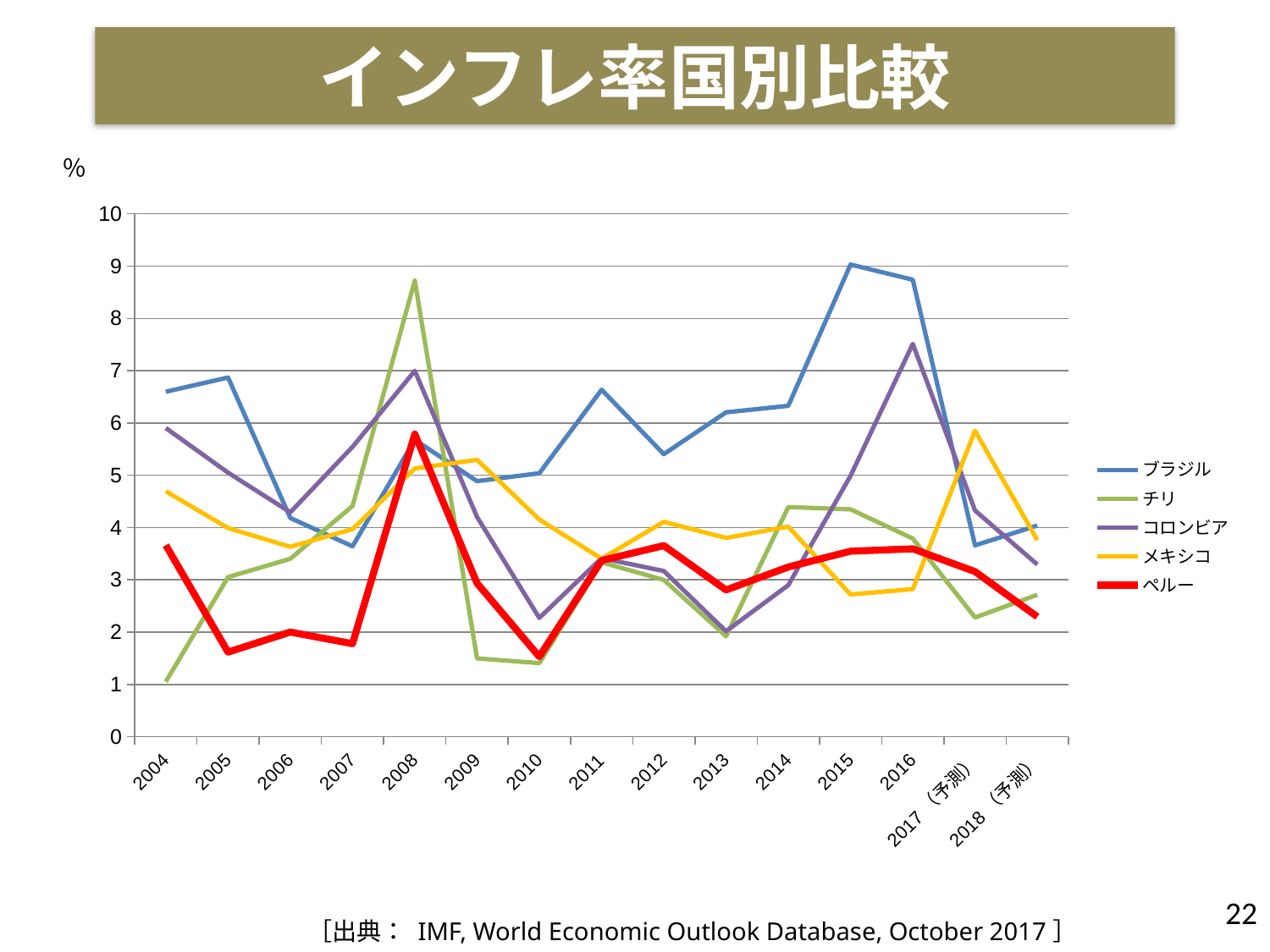
Does the value for ブラジル rise or fall from 2016 to 2017（予測）? fall Which country has the highest inflation rate in 2008? チリ Which country has the lowest inflation rate in 2004? チリ What kind of chart is shown on the slide? line chart How many series does the legend list? 5 What is the title of the chart? インフレ率国別比較 Is the value for メキシコ in 2017（予測） greater or less than 5? greater Which country has the highest inflation rate in 2015? ブラジル Is the value for チリ in 2008 greater or less than 8? greater In 2016, which is higher, ブラジル or コロンビア? ブラジル How many years (points) are shown along the x axis? 15 Is the value for ペルー in 2005 greater or less than 2? less